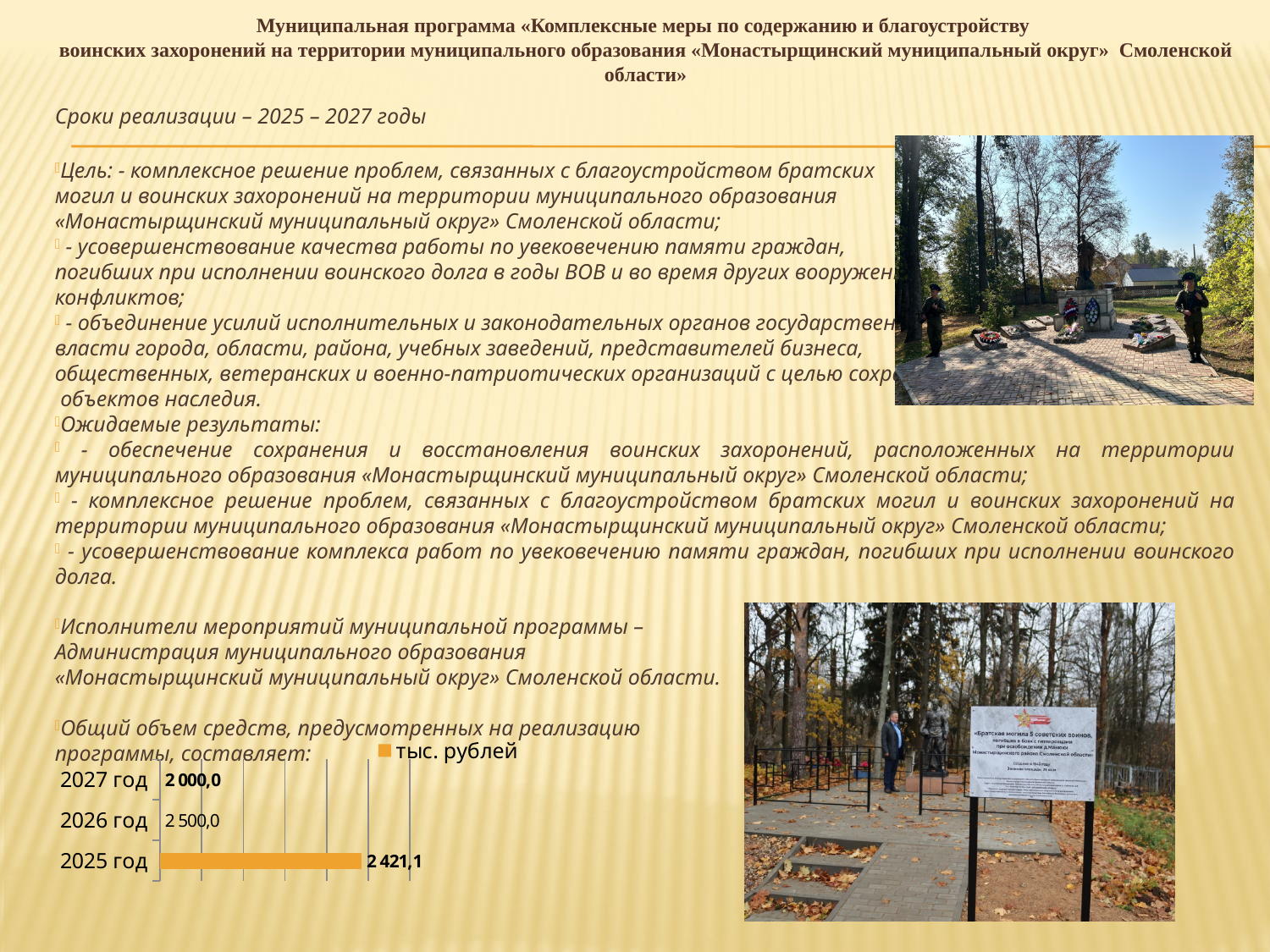
Which year has the lowest value in the bar chart? 2027 год How many series does the legend of the bar chart list? 1 What kind of chart is shown at the bottom of the slide? Bar chart What is the value shown for 2026 год in the bar chart? 2 500,0 What is the difference between the values for 2025 год and 2027 год in the bar chart? 421,1 What is the value shown for 2027 год in the bar chart? 2 000,0 How many years (categories) are shown in the bar chart? 3 What is the difference between the values for 2026 год and 2027 год in the bar chart? 500,0 Which year has the highest value in the bar chart? 2026 год What is the legend entry of the bar chart? тыс. рублей What is the value shown for 2025 год in the bar chart? 2 421,1 Which is larger in the bar chart, the value for 2025 год or for 2027 год? 2025 год